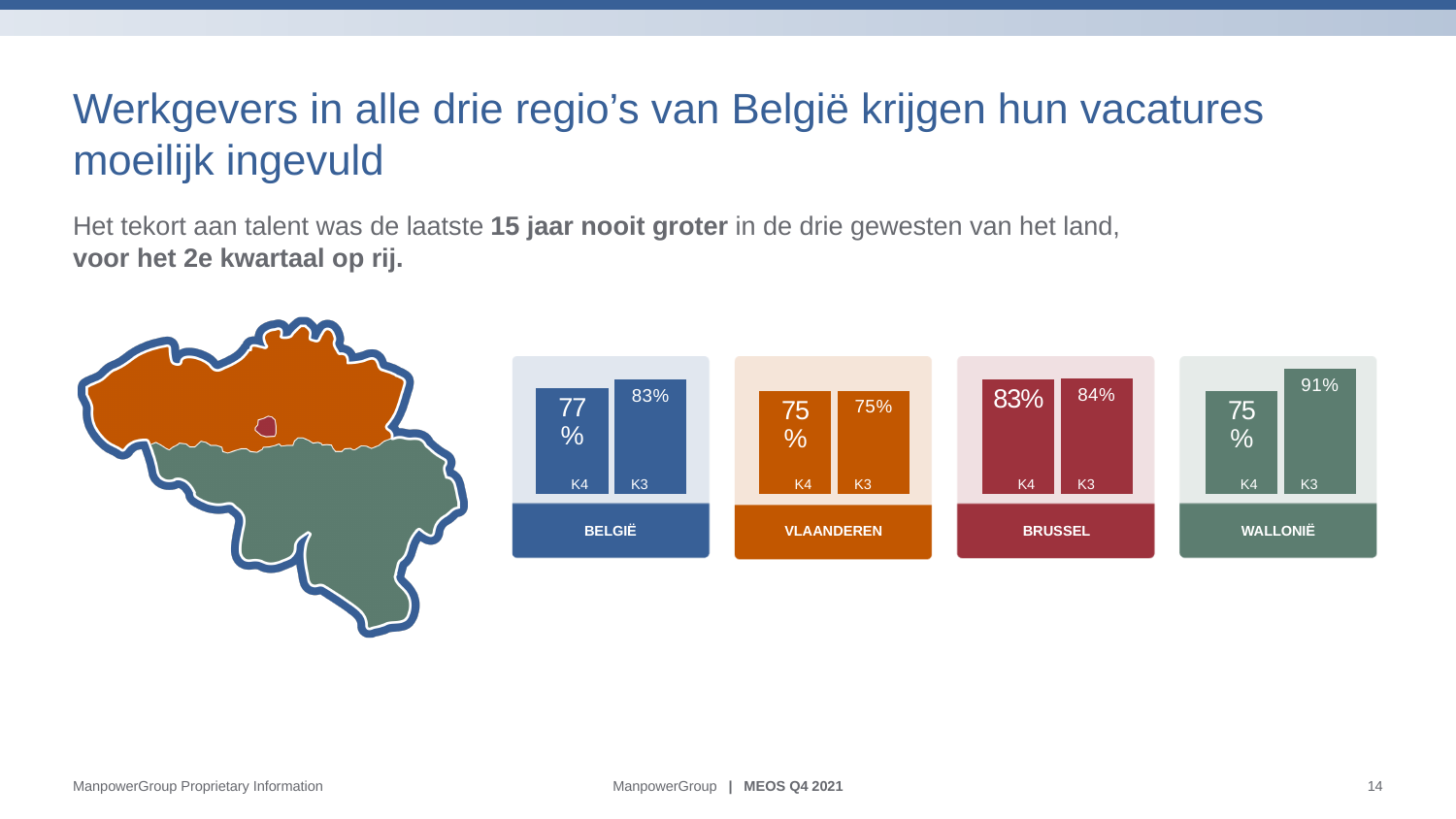
In the BRUSSEL chart, what is the value for K4? 83% How many bars does the VLAANDEREN chart show? 2 In the VLAANDEREN chart, what is the value for K3? 75% What kind of chart is used for the WALLONIË panel? Bar chart In the WALLONIË chart, what is the difference between the K3 and K4 values? 16% In the BELGIË chart, what is the value for K4? 77% In the BELGIË chart, what is the value for K3? 83% In the WALLONIË chart, which is larger, K4 or K3? K3 In the BELGIË chart, what is the difference between the K3 and K4 values? 6% How many regional bar charts are shown on the slide? 4 In the WALLONIË chart, what is the value for K3? 91% In the BRUSSEL chart, what is the difference between the K3 and K4 values? 1%